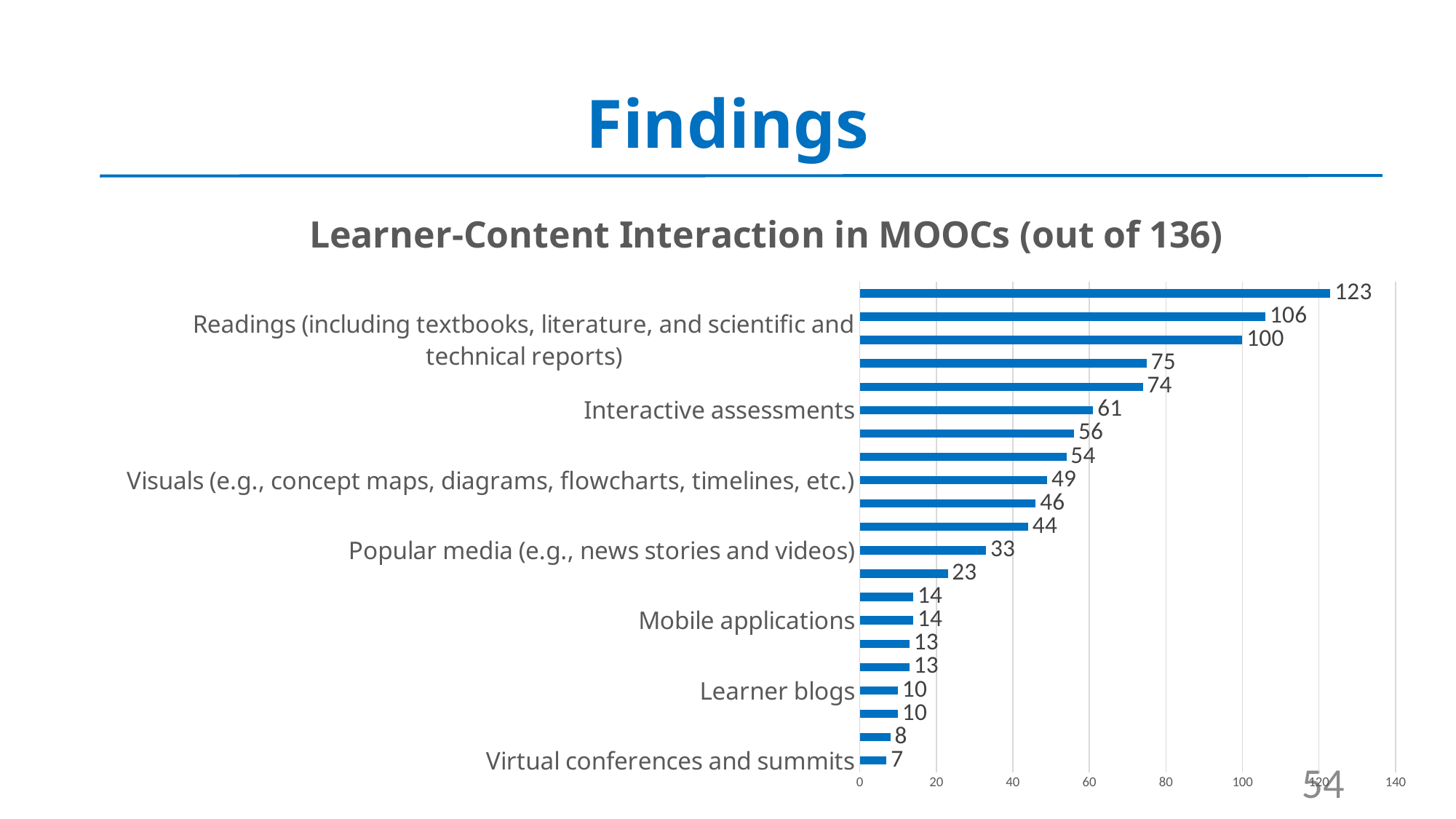
Which is larger, the value for Visuals or the value for Popular media? Visuals How many bars are plotted in the chart? 21 What is the value for Visuals (e.g., concept maps, diagrams, flowcharts, timelines, etc.)? 49 What is the value for Interactive assessments? 61 What type of chart is shown on the slide? bar chart What is the highest value shown in the chart? 123 What is the value for Popular media (e.g., news stories and videos)? 33 What is the title of the chart? Learner-Content Interaction in MOOCs (out of 136) What is the difference between the values for Readings and Interactive assessments? 39 Which labeled category has the lowest value? Virtual conferences and summits What is the value for Virtual conferences and summits? 7 What is the value for Readings (including textbooks, literature, and scientific and technical reports)? 100